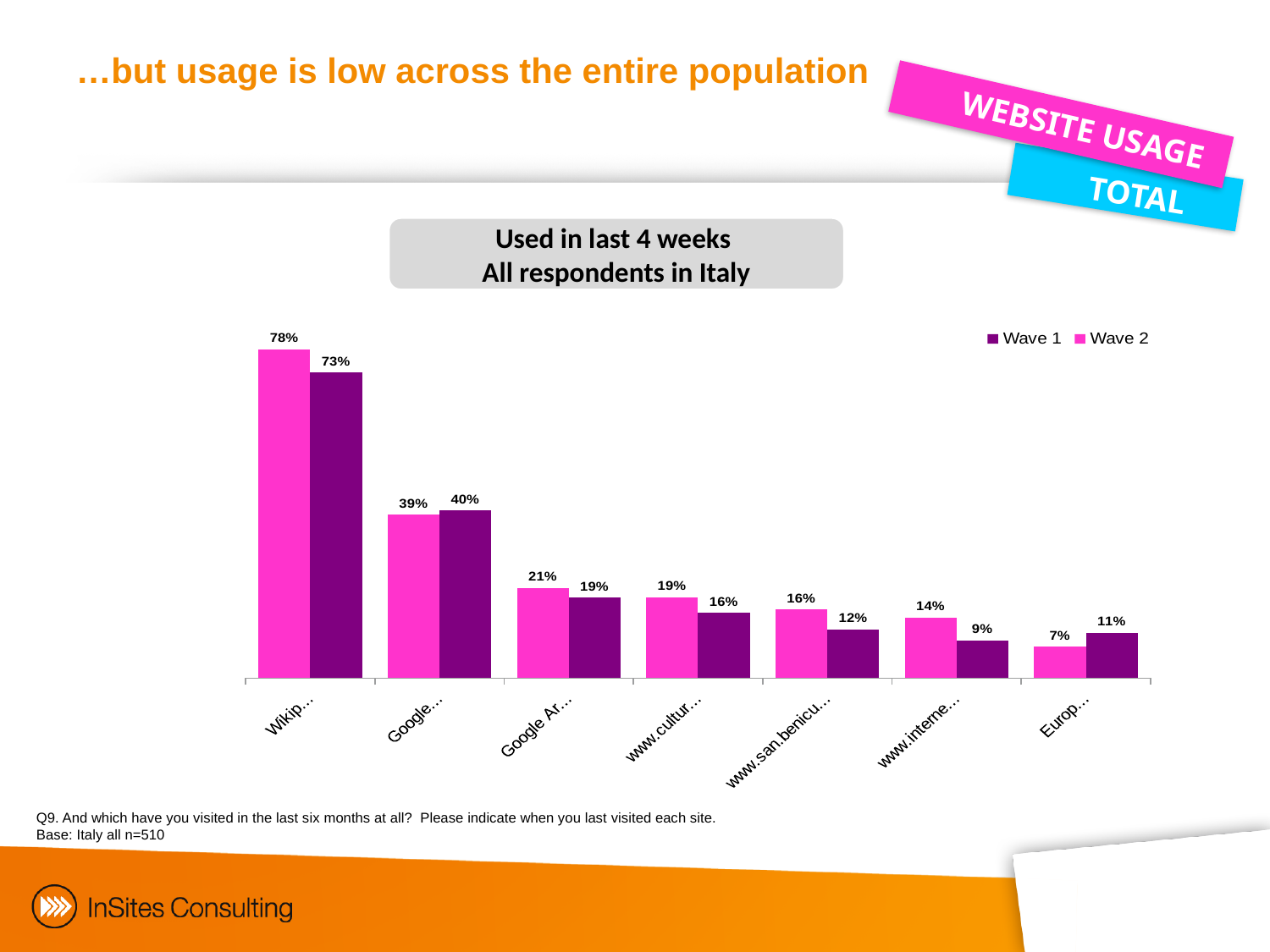
Which category has the highest Wave 2 (pink) value? Wikip... How many website categories are shown on the x axis of the chart? 7 What is the Wave 1 (purple) value for the 'Europ...' category? 11% How many series does the chart legend list? 2 What type of chart is shown on the slide? Bar chart Which category has the lowest Wave 1 (purple) value? www.interne... Which category has the lowest Wave 2 (pink) value? Europ... What is the Wave 2 (pink) value for the 'Wikip...' category? 78% What is the Wave 1 (purple) value for the 'Wikip...' category? 73% What is the difference between the Wave 2 and Wave 1 values for the 'Wikip...' category? 5 percentage points What is the title shown above the chart? Used in last 4 weeks All respondents in Italy For the 'Google...' category, which is larger: the Wave 1 value or the Wave 2 value? Wave 1